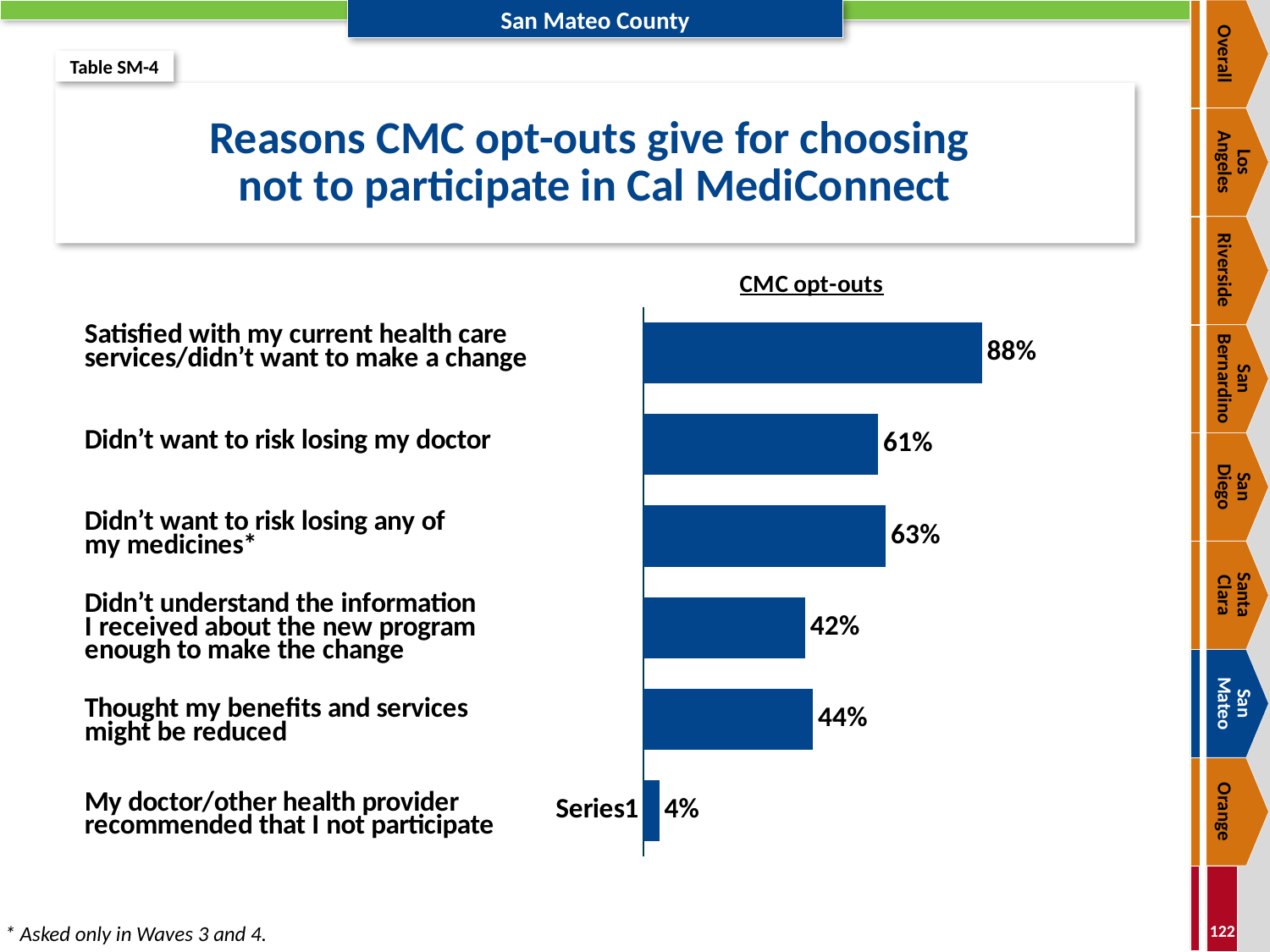
What type of chart is shown on the slide? Bar chart What percentage of CMC opt-outs said their doctor/other health provider recommended that they not participate? 4% What percentage of CMC opt-outs said they didn't want to risk losing their doctor? 61% What percentage of CMC opt-outs said they didn't understand the information they received about the new program enough to make the change? 42% What percentage of CMC opt-outs said they didn't want to risk losing any of their medicines? 63% How many reasons are shown in the chart? 6 What is the title shown above the chart? CMC opt-outs What is the difference in percentage points between 'Satisfied with my current health care services/didn't want to make a change' and 'Didn't want to risk losing my doctor'? 27 percentage points Which reason has the lowest percentage of CMC opt-outs? My doctor/other health provider recommended that I not participate Which reason has the highest percentage of CMC opt-outs? Satisfied with my current health care services/didn't want to make a change What percentage of CMC opt-outs said they were satisfied with their current health care services/didn't want to make a change? 88% Which reason has a higher percentage: 'Thought my benefits and services might be reduced' or 'Didn't understand the information I received about the new program enough to make the change'? Thought my benefits and services might be reduced